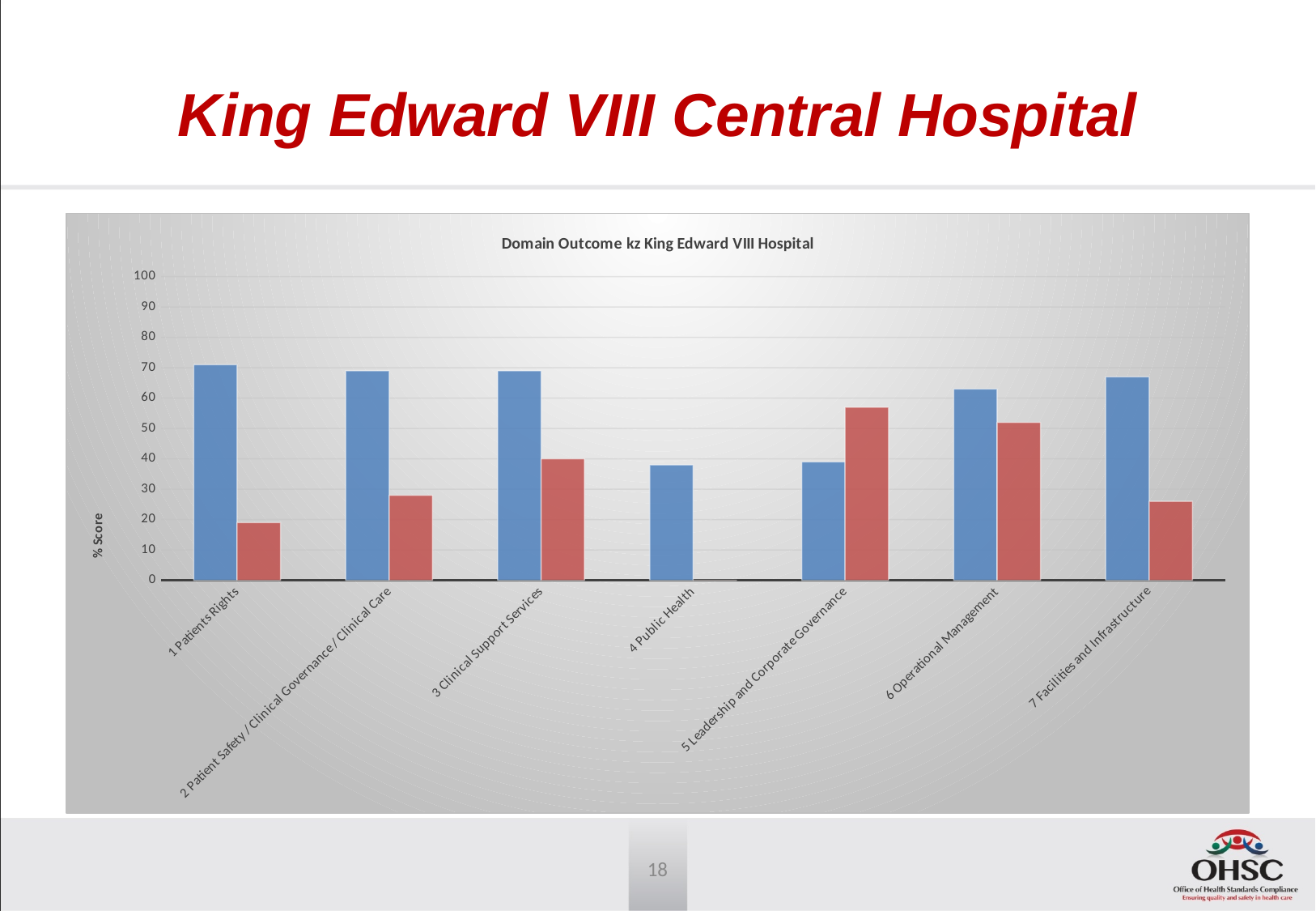
Is the red bar for 1 Patients Rights greater or less than 30? less Is the blue bar for 1 Patients Rights greater or less than 60? greater What is the title of the chart? Domain Outcome kz King Edward VIII Hospital Is the red bar for 7 Facilities and Infrastructure greater or less than 40? less What is the label on the vertical axis of the chart? % Score Which category has the highest red bar? 5 Leadership and Corporate Governance For 5 Leadership and Corporate Governance, which bar is larger, the blue bar or the red bar? the red bar What kind of chart is shown on the slide? bar chart How many domain categories are shown on the x axis of the chart? 7